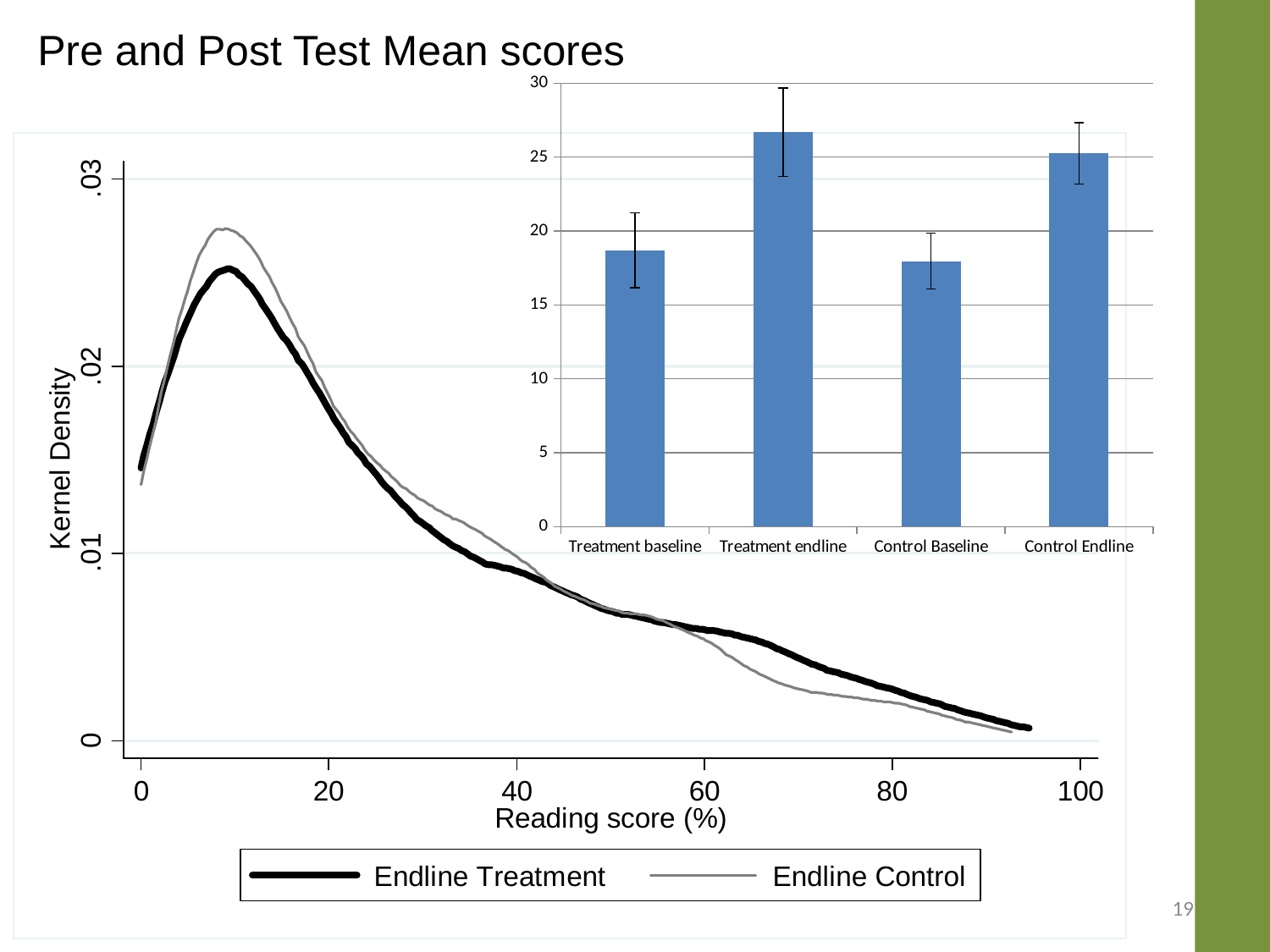
In the bar chart in the top right, which category has the highest bar? Treatment endline What kind of chart is the large chart on the left of the slide? line chart In the bar chart in the top right, is the value for Control Baseline greater or less than 20? less In the kernel density line chart, do the values rise or fall as the reading score increases from 20 to 100? fall What kind of chart is the inset chart in the top right of the slide? bar chart What is the x-axis label of the kernel density line chart? Reading score (%) In the bar chart in the top right, which is larger, the value for Control Baseline or the value for Control Endline? Control Endline In the bar chart in the top right, which is larger, the value for Treatment baseline or the value for Treatment endline? Treatment endline In the kernel density line chart, how many series does the legend list? 2 In the bar chart in the top right, how many categories are shown on the x axis? 4 In the bar chart in the top right, is the value for Treatment baseline greater or less than 20? less In the bar chart in the top right, is the value for Treatment endline greater or less than 25? greater